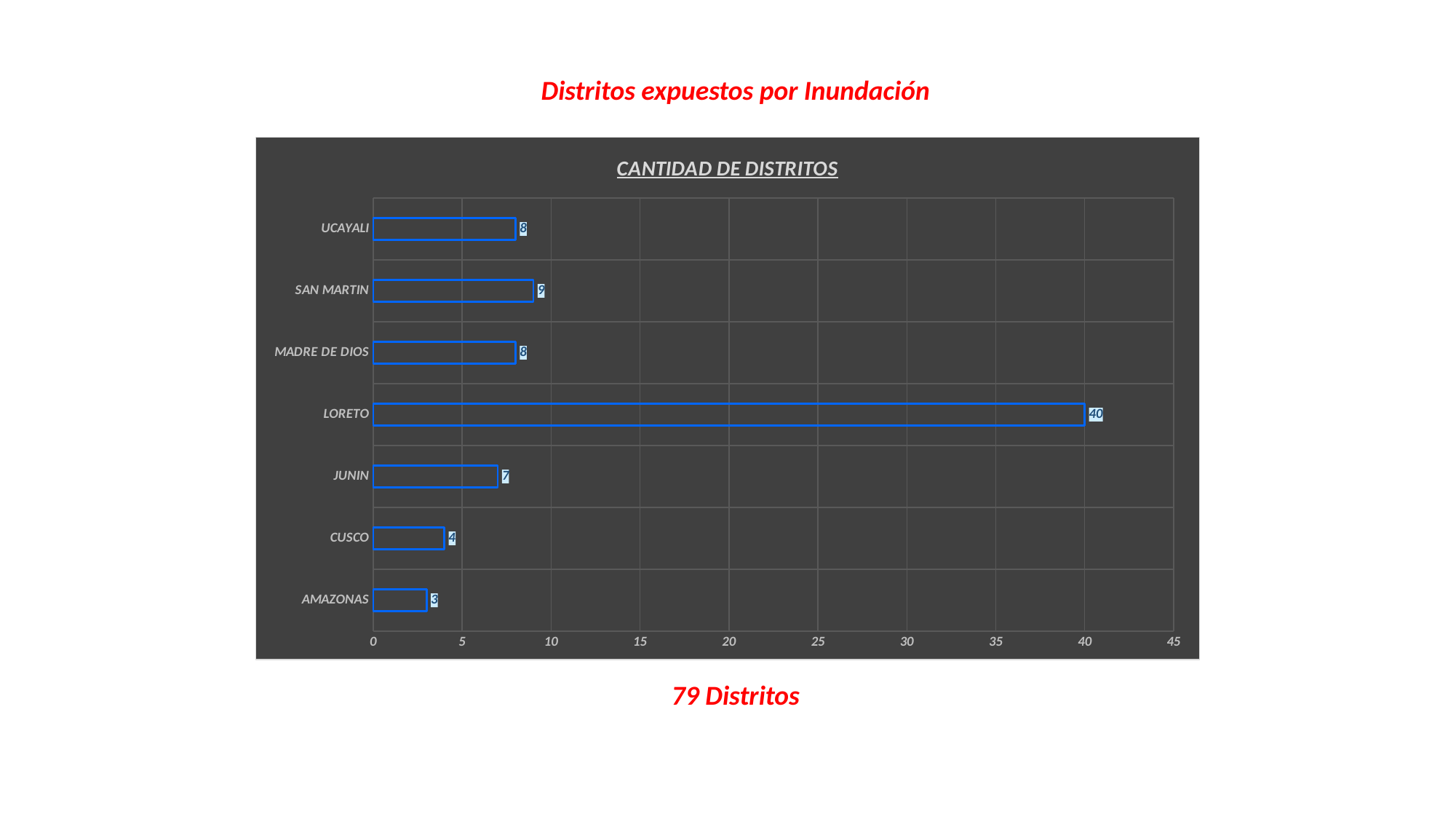
What is the value for CUSCO? 4 What is the difference between the values for LORETO and SAN MARTIN? 31 Which is larger, the value for JUNIN or the value for CUSCO? JUNIN What kind of chart is shown? bar chart Which category has the highest value? LORETO What is the value for LORETO? 40 What is the value for SAN MARTIN? 9 What is the title of the chart? CANTIDAD DE DISTRITOS Which category has the lowest value? AMAZONAS What is the difference between the values for UCAYALI and AMAZONAS? 5 How many categories are shown in the chart? 7 Is the value for LORETO greater or less than 35? greater